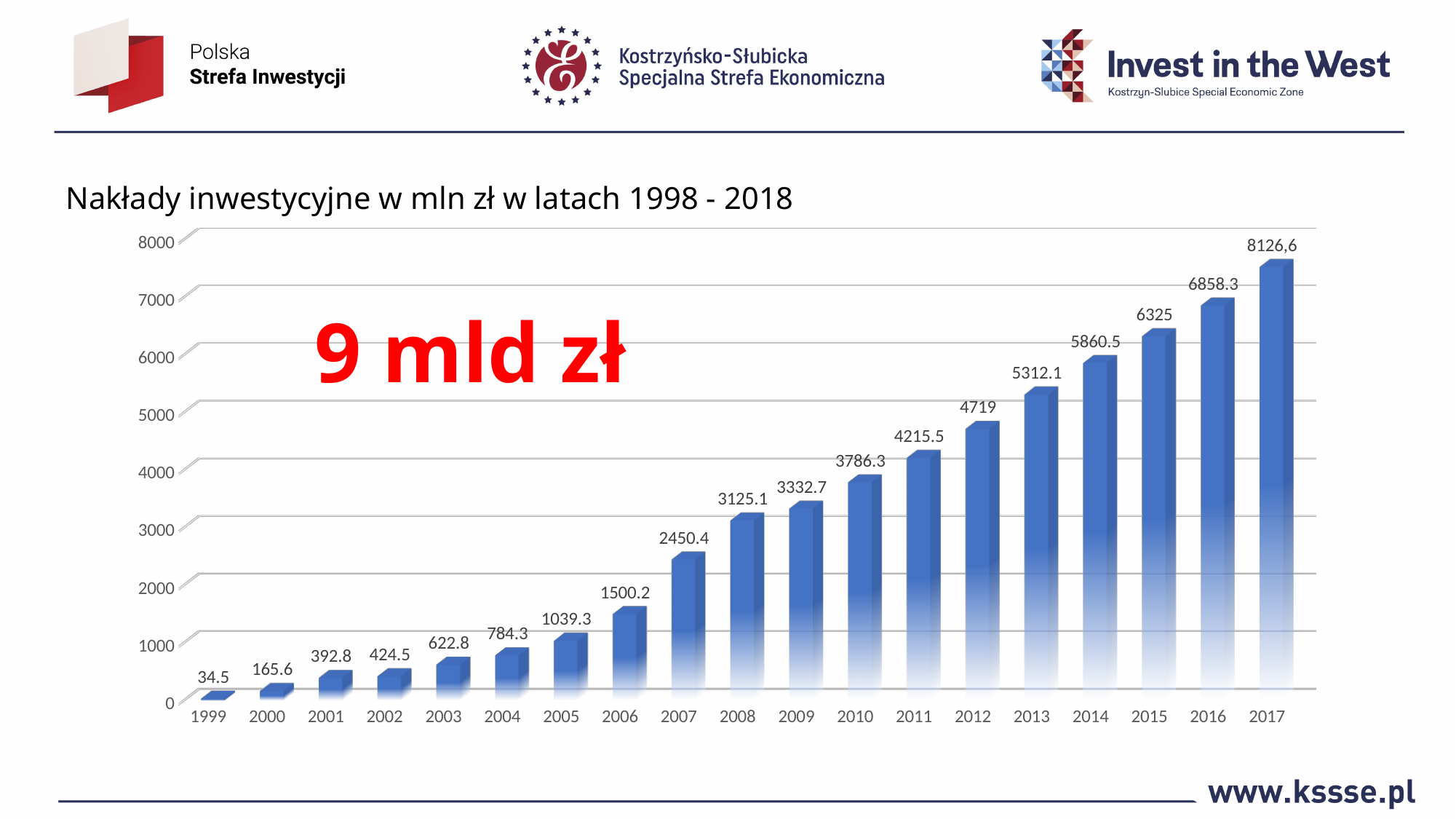
Which is larger, the value for 2009 or the value for 2010? 2010 What is the value for 1999? 34.5 Which year has the lowest value? 1999 What is the value for 2017? 8126,6 What is the value for 2007? 2450.4 Which year has the highest value? 2017 What is the value for 2012? 4719 What kind of chart is shown? bar chart What is the difference between the values for 2015 and 2014? 464.5 How many years are shown on the x axis? 19 Do the values rise or fall from 1999 to 2017? rise What is the difference between the values for 2012 and 2011? 503.5